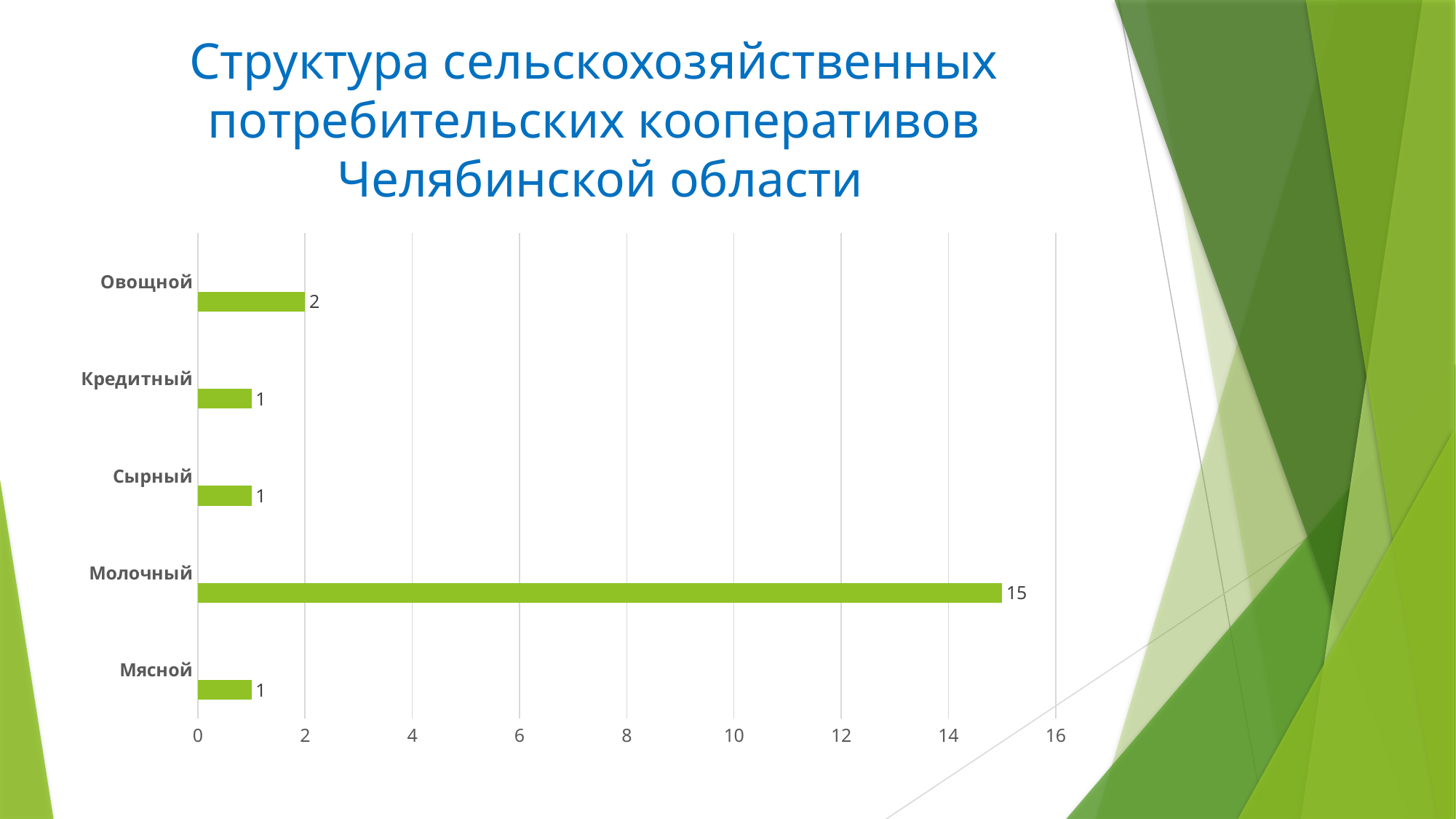
What is the title of the slide? Структура сельскохозяйственных потребительских кооперативов Челябинской области What is the value for Овощной? 2 What is the highest value shown on the horizontal axis? 16 Which category has the highest value? Молочный Is the value for Молочный greater or less than 10? greater What is the value for Молочный? 15 How many categories are shown in the chart? 5 What is the value for Кредитный? 1 Which is larger, the value for Овощной or the value for Сырный? Овощной What kind of chart is shown on the slide? bar chart What is the difference between the values for Молочный and Овощной? 13 What is the total of all the values shown in the chart? 20